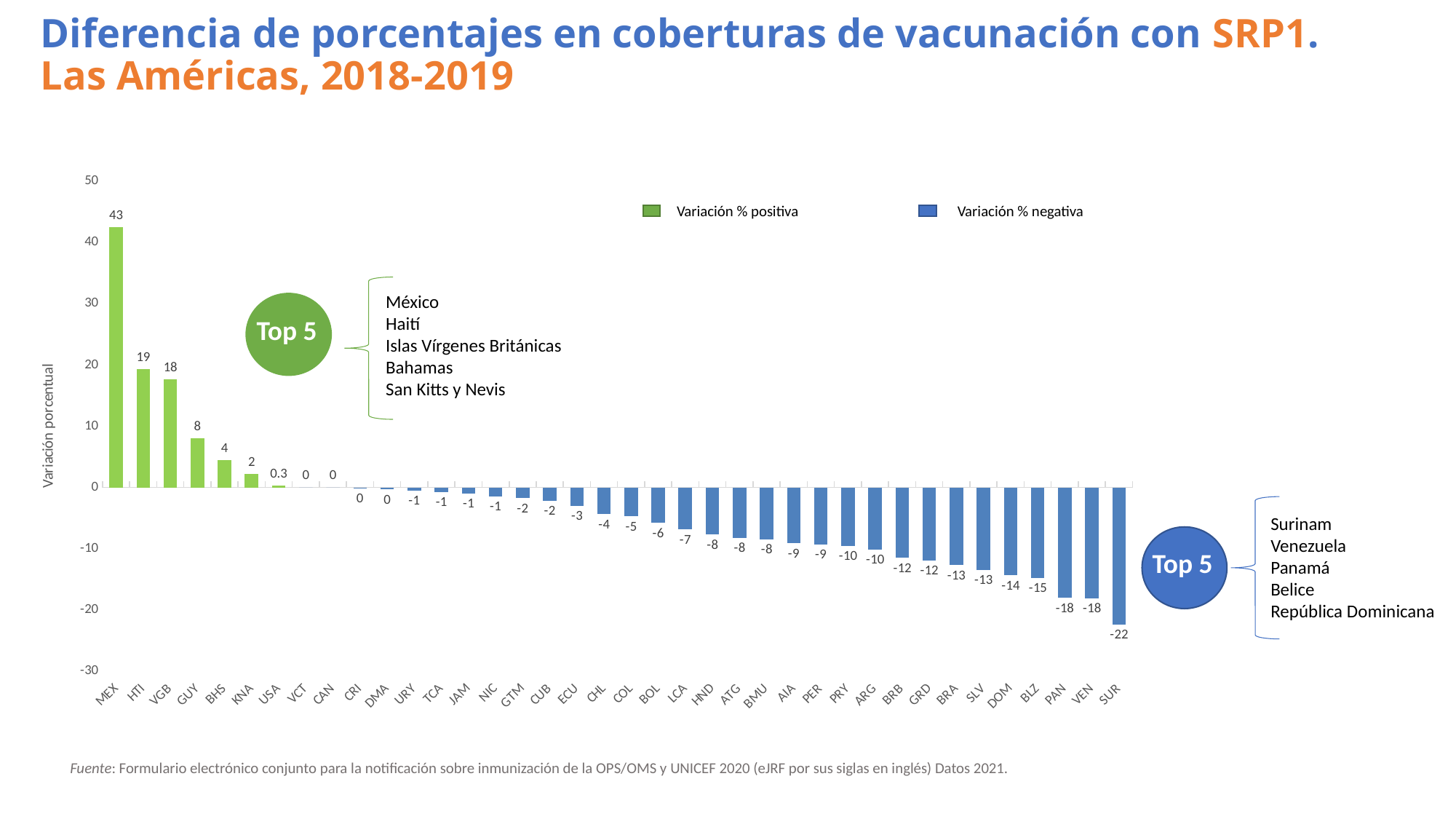
Which has a larger value, GUY or BHS? GUY What kind of chart is shown? bar chart What is the value for BLZ? -15 How many series does the legend list? 2 What is the value for USA? 0.3 Which country has the highest value? MEX Do the values rise or fall from left to right along the x axis? fall What is the value for MEX? 43 How many countries are shown on the x axis? 38 Which country has the lowest value? SUR What is the value for SUR? -22 What is the difference between the values for MEX and HTI? 24